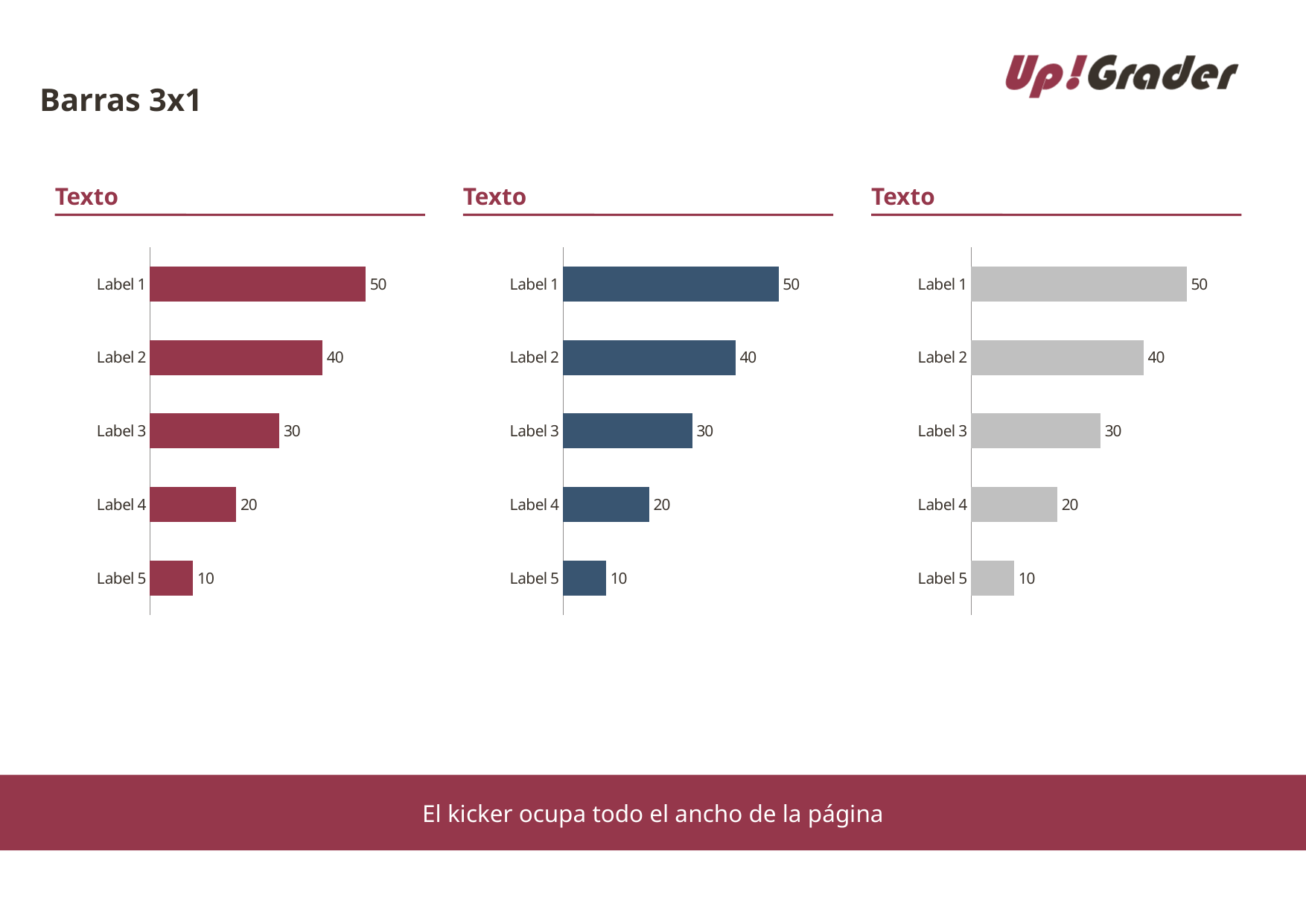
What kind of chart is the right chart? Bar chart In the middle chart, what is the difference between the values for Label 1 and Label 4? 30 In the left chart, do the values rise or fall from Label 1 to Label 5? Fall In the right chart, what is the value for Label 2? 40 What colour are the bars in the middle chart? Dark blue In the left chart, which category has the highest value? Label 1 In the left chart, which is larger, the value for Label 2 or the value for Label 4? Label 2 In the left chart, what is the value for Label 3? 30 How many categories does the middle chart show? 5 How many charts are on the slide? 3 In the right chart, which category has the lowest value? Label 5 In the middle chart, what is the value for Label 5? 10